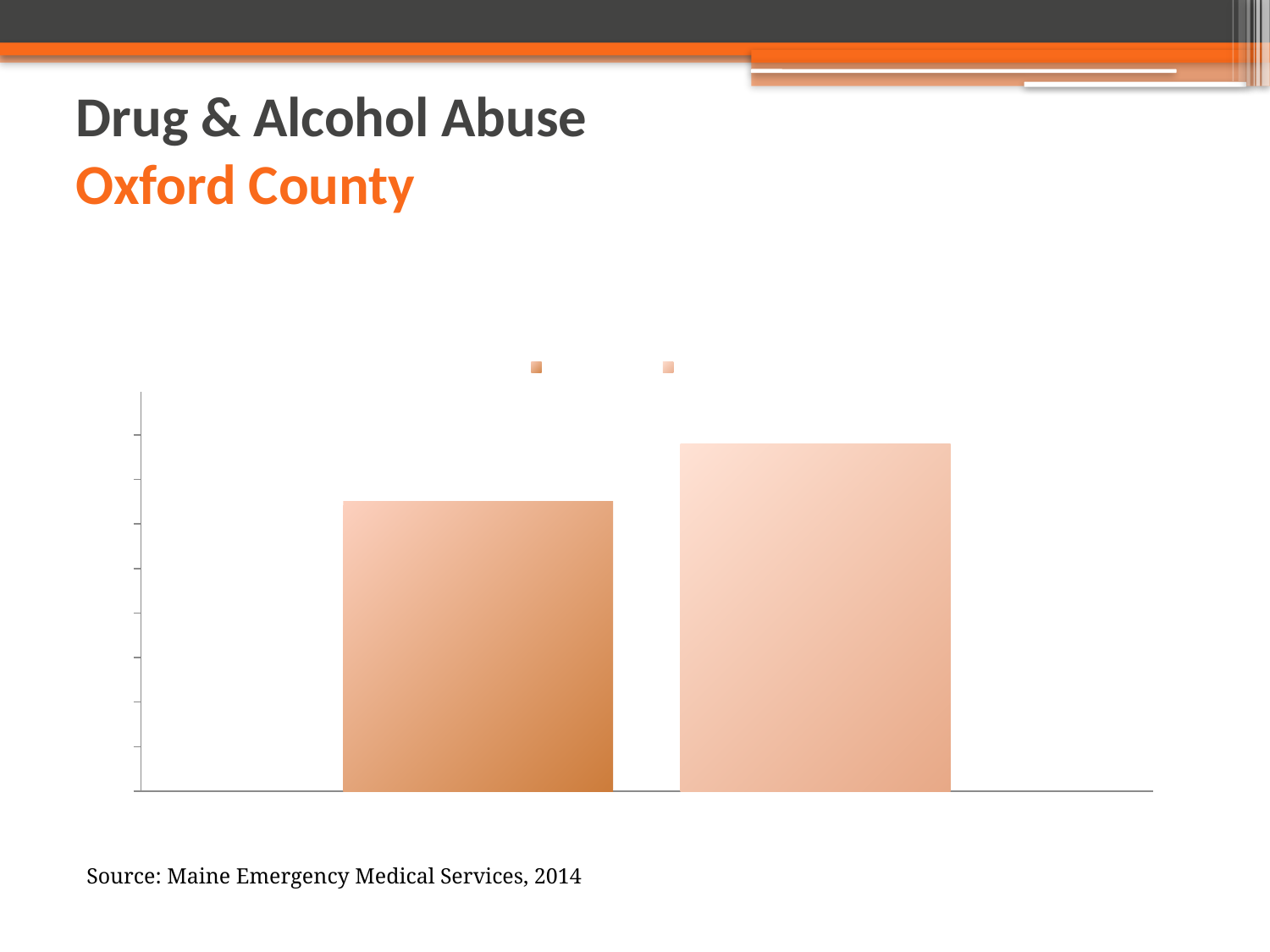
What source is cited below the chart? Maine Emergency Medical Services, 2014 What kind of chart is shown on the slide? bar chart Which bar is drawn in the darker orange colour, the left or the right? the left bar Which bar is taller, the left bar or the right bar? the right bar How many bars are plotted in the chart? 2 How many entries does the chart's legend list? 2 Which bar is the shortest in the chart? the left bar Which bar is the tallest in the chart? the right bar